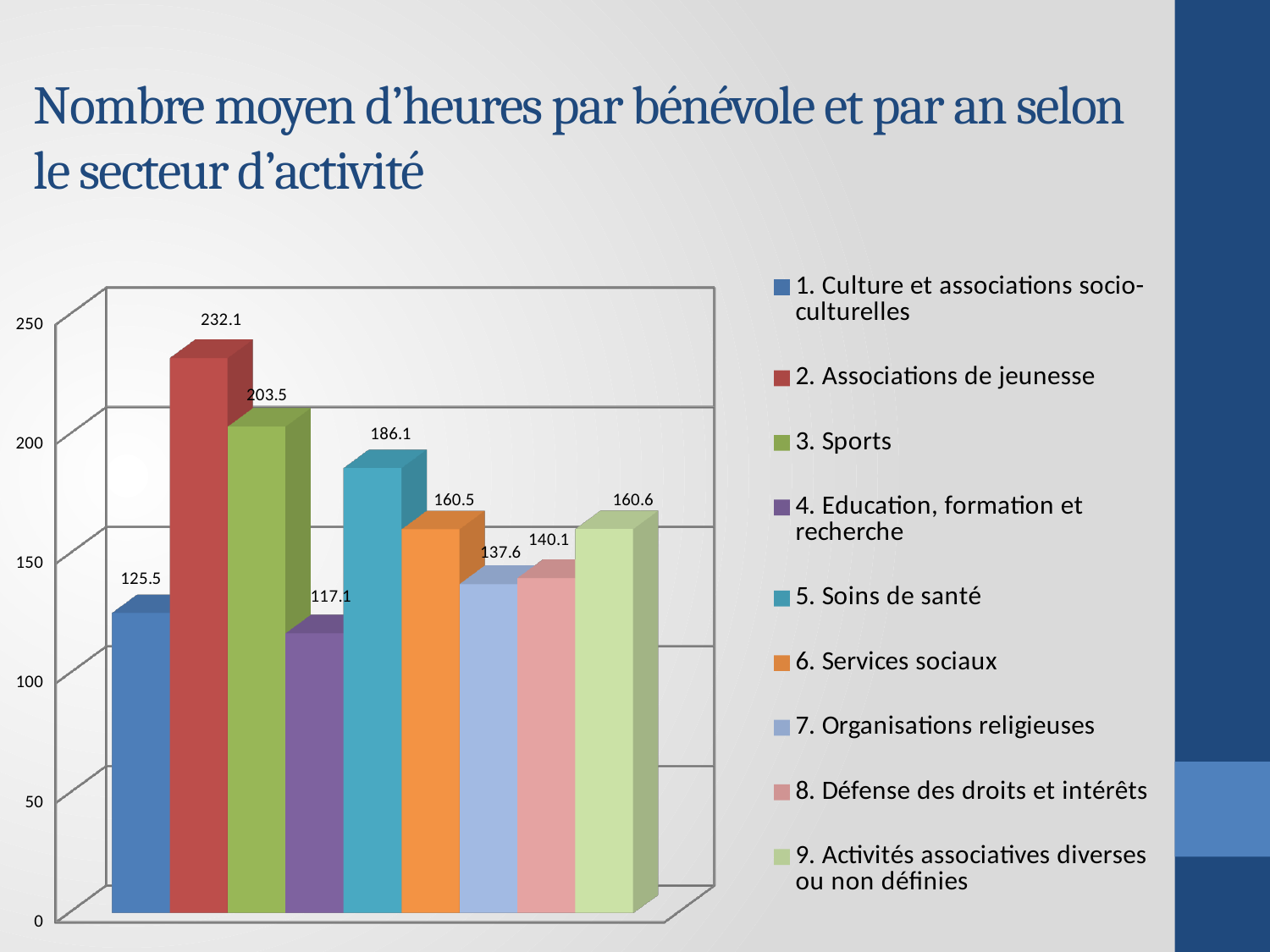
Which is larger, the value for 3. Sports or the value for 5. Soins de santé? 3. Sports Which sector has the lowest value? 4. Education, formation et recherche How many bars are plotted in the chart? 9 What kind of chart is shown on the slide? bar chart What is the value for 2. Associations de jeunesse? 232.1 What is the difference between the values for 2. Associations de jeunesse and 3. Sports? 28.6 Is the value for 8. Défense des droits et intérêts greater or less than 150? less What is the value for 5. Soins de santé? 186.1 What is the difference between the values for 1. Culture et associations socio-culturelles and 4. Education, formation et recherche? 8.4 Which sector has the highest value? 2. Associations de jeunesse What is the value for 7. Organisations religieuses? 137.6 How many entries does the legend list? 9